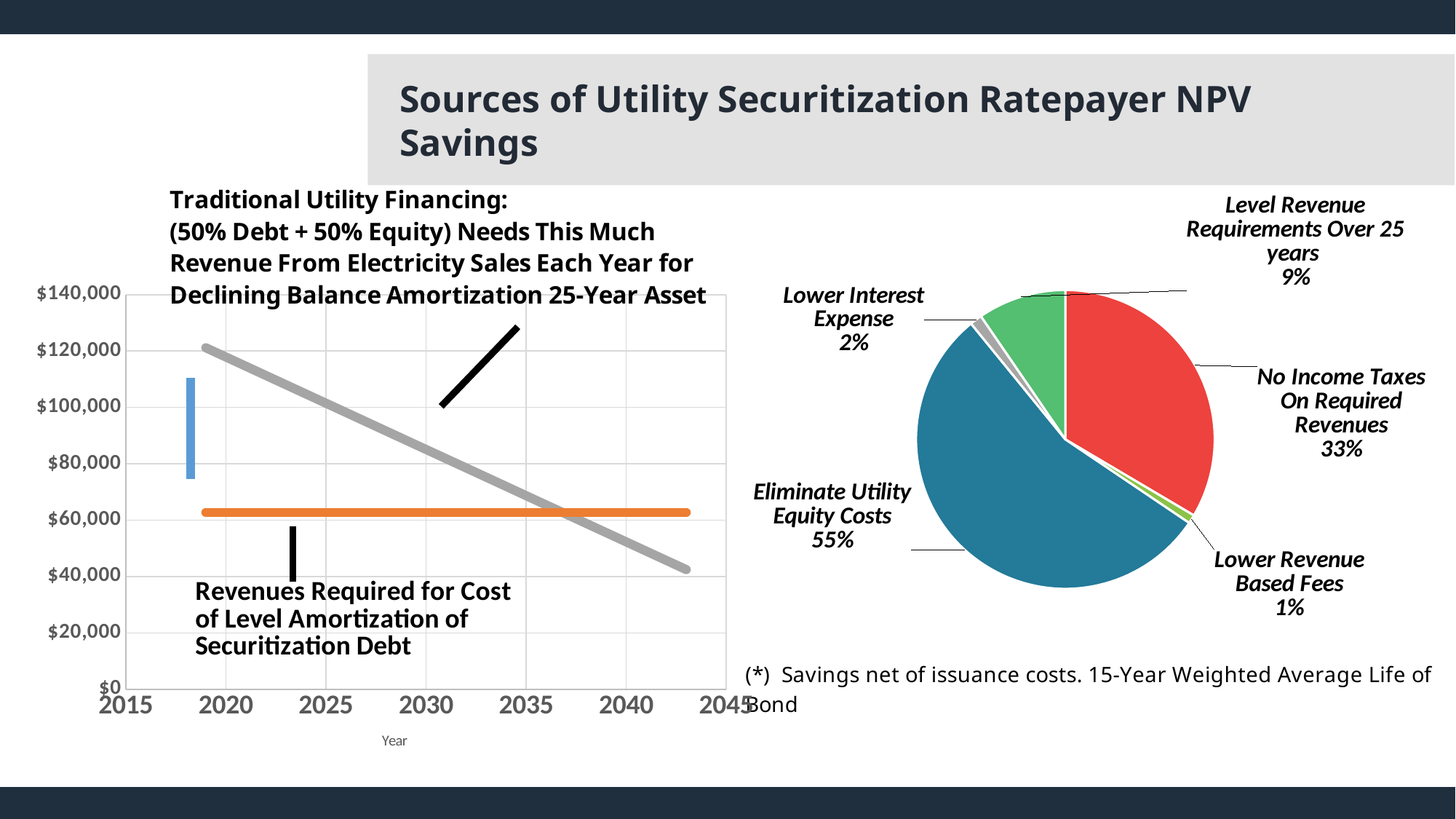
In the pie chart, how many slices are there? 5 What kind of chart is the chart on the left of the slide? line chart In the pie chart, what share is attributed to No Income Taxes On Required Revenues? 33% In the line chart on the left, does the gray Traditional Utility Financing line rise or fall from 2020 to 2040? fall In the pie chart, what share is attributed to Lower Interest Expense? 2% What kind of chart is the chart on the right of the slide? pie chart In the pie chart, what is the difference in share between Eliminate Utility Equity Costs and No Income Taxes On Required Revenues? 22% In the pie chart, which slice is the smallest? Lower Revenue Based Fees In the pie chart, what share is attributed to Level Revenue Requirements Over 25 years? 9% In the pie chart, which slice is the largest? Eliminate Utility Equity Costs In the line chart on the left, is the value of the gray Traditional Utility Financing line in 2020 greater or less than $100,000? greater